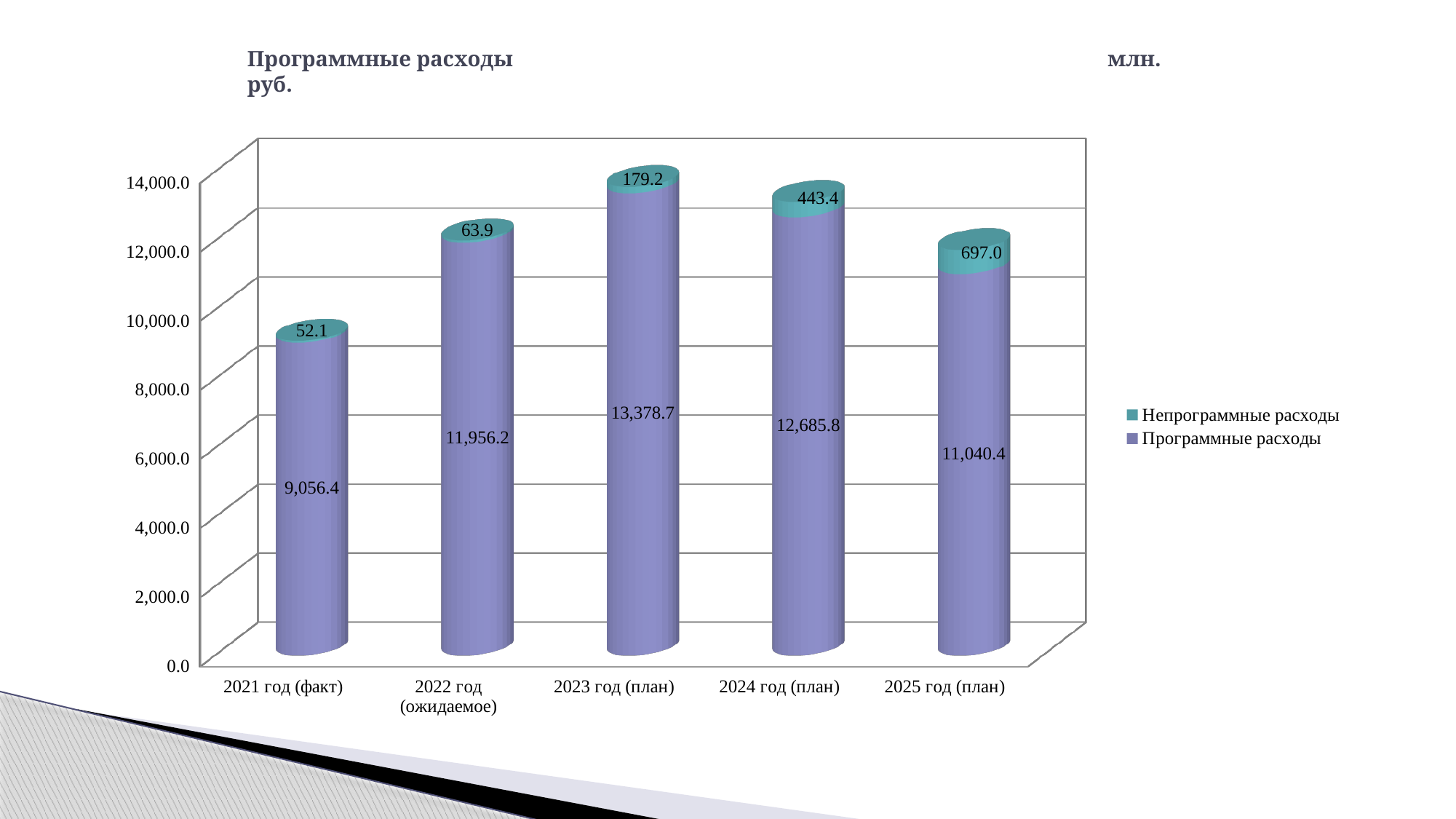
How many years are shown on the x axis? 5 What is the value of Программные расходы for 2021 год (факт)? 9,056.4 What is the value of Программные расходы for 2023 год (план)? 13,378.7 What kind of chart is shown on the slide? Stacked bar chart What is the difference between Программные расходы in 2022 год (ожидаемое) and 2021 год (факт)? 2,899.8 What is the total of the stacked bar for 2025 год (план)? 11,737.4 Which year has the lowest value of Непрограммные расходы? 2021 год (факт) Which is larger: Непрограммные расходы in 2024 год (план) or in 2023 год (план)? 2024 год (план) Which colour represents Непрограммные расходы in the legend? Teal Which year has the highest value of Программные расходы? 2023 год (план) What is the value of Непрограммные расходы for 2025 год (план)? 697.0 How many series does the legend list? 2